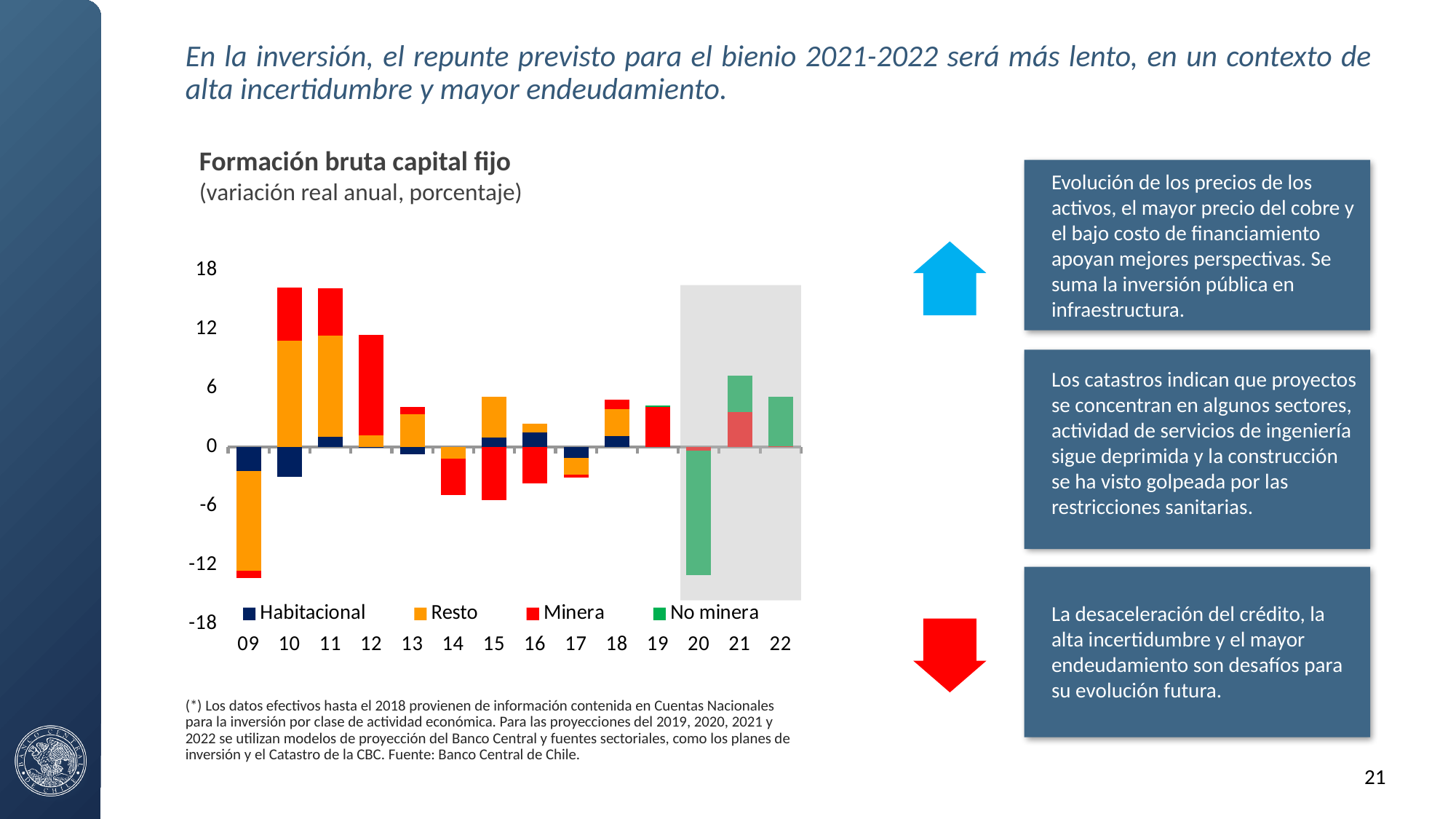
How many series does the legend list? 4 Is the top of the positive stacked bar for 10 greater or less than 12? greater Is the top of the positive stacked bar for 21 greater or less than 6? greater Is the top of the positive stacked bar for 11 greater or less than 12? greater What is the title of the chart? Formación bruta capital fijo Which year has the taller positive stacked bar, 21 or 22? 21 Do the positive stacked bars generally rise or fall from 11 to 17? fall How many years are shown on the x axis of the chart? 14 Which series is shown in orange in the legend? Resto What kind of chart is shown on the slide? bar chart